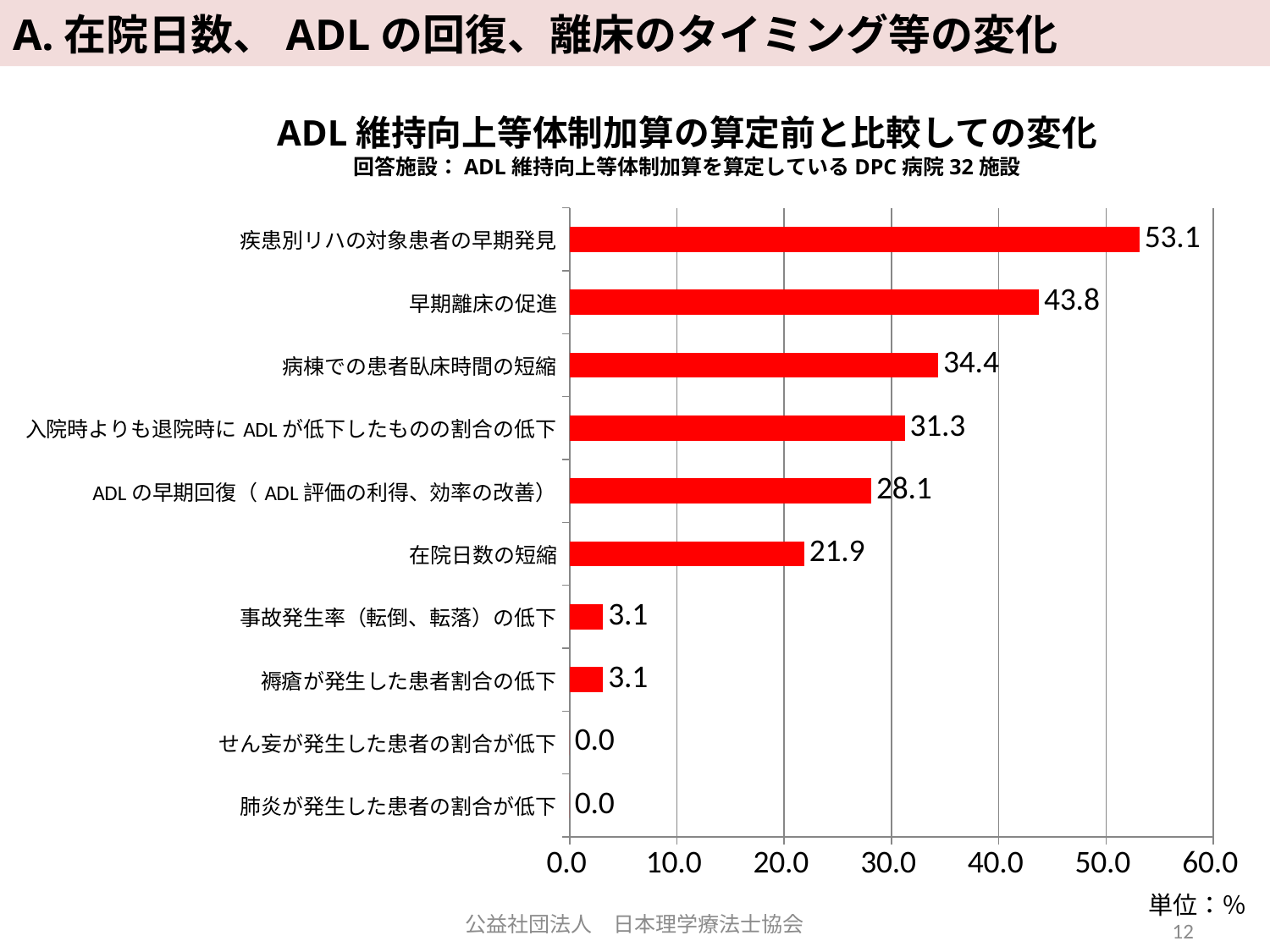
What is the difference between the values for 早期離床の促進 and 病棟での患者臥床時間の短縮? 9.4 What kind of chart is shown on the slide? Bar chart Which category has the highest value? 疾患別リハの対象患者の早期発見 What is the value for 早期離床の促進? 43.8 Is the value for 病棟での患者臥床時間の短縮 greater or less than 30.0? greater Which is larger, the value for 入院時よりも退院時に ADL が低下したものの割合の低下 or the value for 在院日数の短縮? 入院時よりも退院時に ADL が低下したものの割合の低下 How many categories have a value of 0.0? 2 What is the value for ADL の早期回復（ADL 評価の利得、効率の改善）? 28.1 What is the title of the chart? ADL 維持向上等体制加算の算定前と比較しての変化 What is the value for 疾患別リハの対象患者の早期発見? 53.1 How many categories are shown in the chart? 10 What is the value for 在院日数の短縮? 21.9